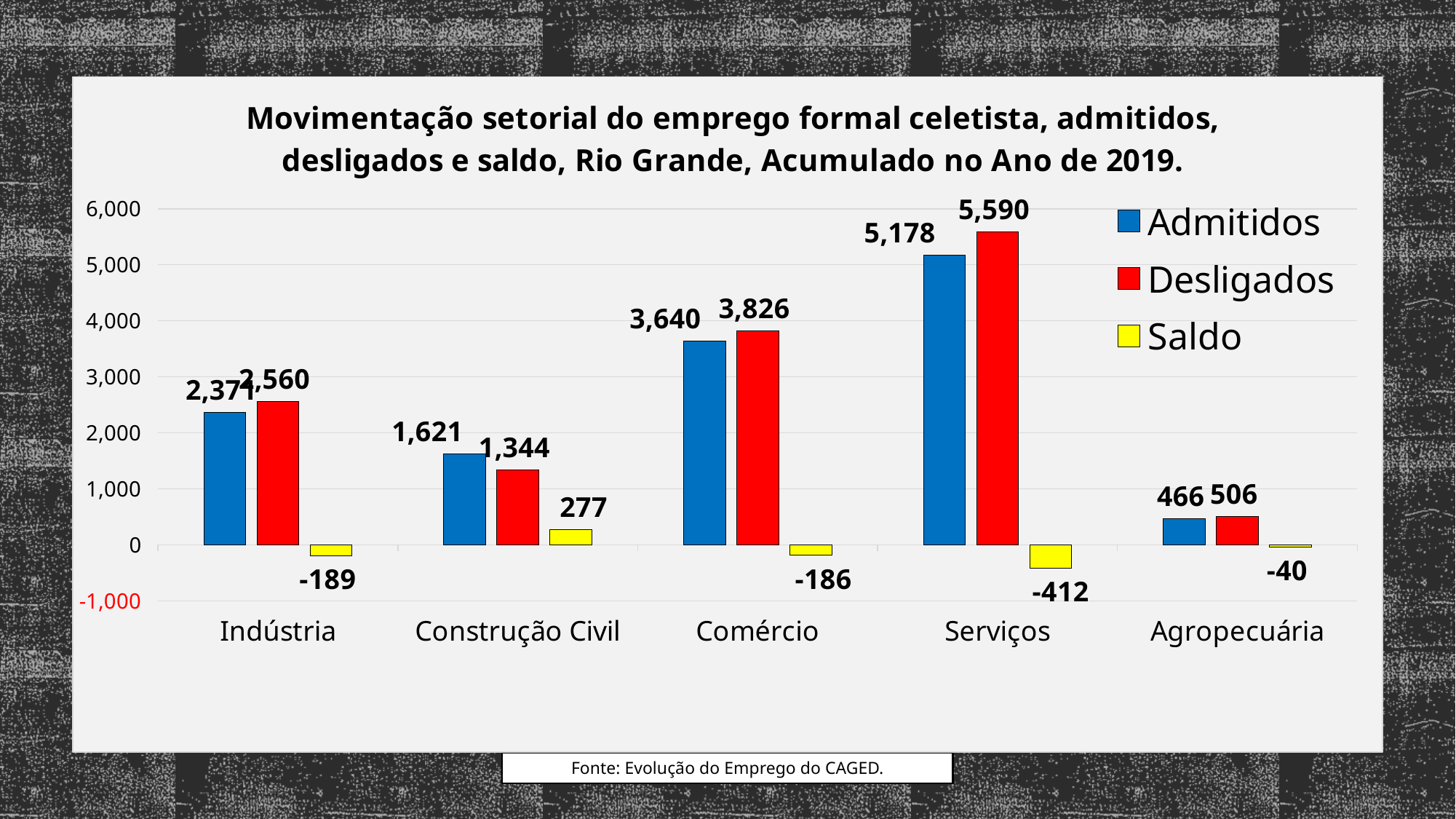
What is the Saldo value for Agropecuária? -40 How many sectors are shown on the x axis? 5 What kind of chart is shown on the slide? Bar chart Which colour represents the Saldo series in the legend? Yellow What is the Saldo value for Construção Civil? 277 How many series does the legend list? 3 What is the Admitidos value for Serviços? 5,178 Which sector has the lowest Admitidos value? Agropecuária Which is larger for Construção Civil, Admitidos or Desligados? Admitidos What is the difference between Desligados and Admitidos for Indústria? 189 Which sector has the highest Desligados value? Serviços What is the Desligados value for Comércio? 3,826